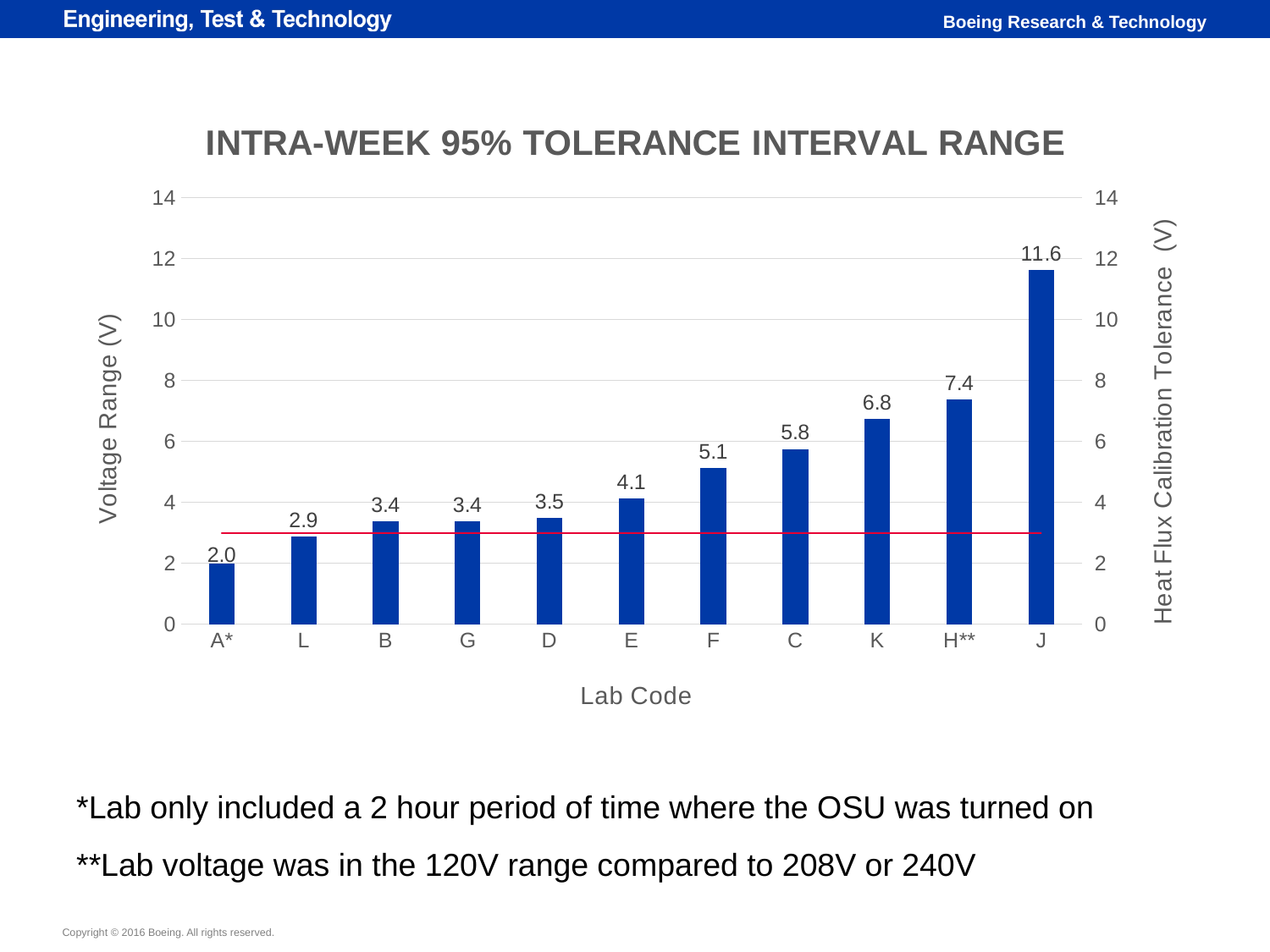
What is the difference between the voltage range values for lab codes K and F? 1.7 Which lab code has the lowest voltage range? A* Which lab code has the highest voltage range? J What type of chart is shown on the slide? Combination bar and line chart What is the difference between the voltage range values for lab codes J and H**? 4.2 What is the voltage range value for lab code A*? 2.0 What is the voltage range value for lab code J? 11.6 How many lab codes are shown on the x axis? 11 What is the voltage range value for lab code C? 5.8 What is the title of the chart? INTRA-WEEK 95% TOLERANCE INTERVAL RANGE Do the bar values rise or fall from left to right along the x axis? Rise Which has a larger voltage range, lab code E or lab code L? E